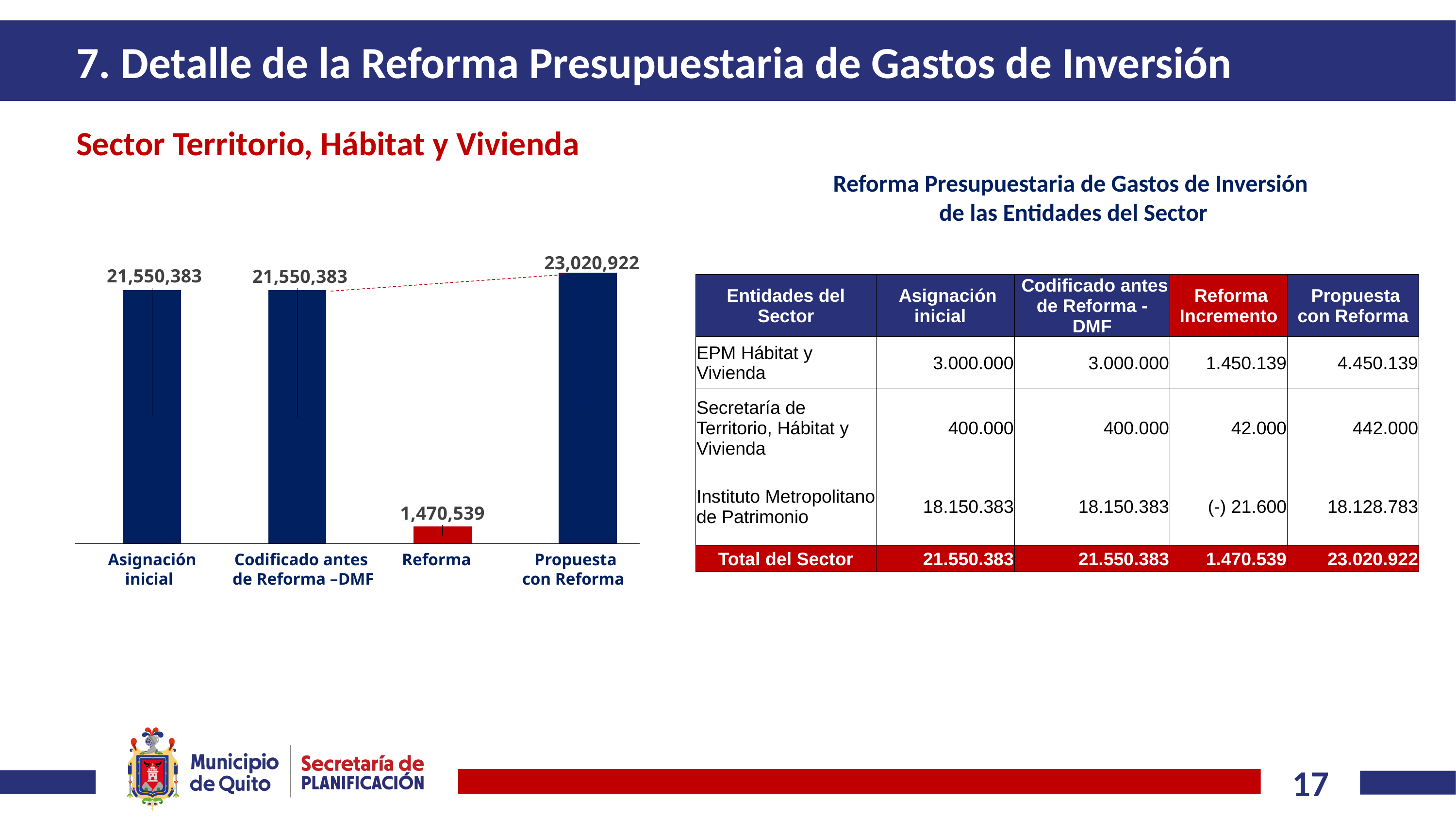
What type of chart is shown on the slide? Bar chart What is the value of the Asignación inicial bar? 21,550,383 What is the value of the Codificado antes de Reforma –DMF bar? 21,550,383 What is the sum of the Codificado antes de Reforma –DMF value and the Reforma value? 23,020,922 Which category has the highest value in the bar chart? Propuesta con Reforma Which is larger, the Propuesta con Reforma bar or the Asignación inicial bar? Propuesta con Reforma What is the value of the Propuesta con Reforma bar? 23,020,922 How many bars are shown in the chart? 4 What is the value of the Reforma bar? 1,470,539 What colour is the Reforma bar? Red Which category has the lowest value in the bar chart? Reforma What is the difference between the Propuesta con Reforma value and the Codificado antes de Reforma –DMF value? 1,470,539